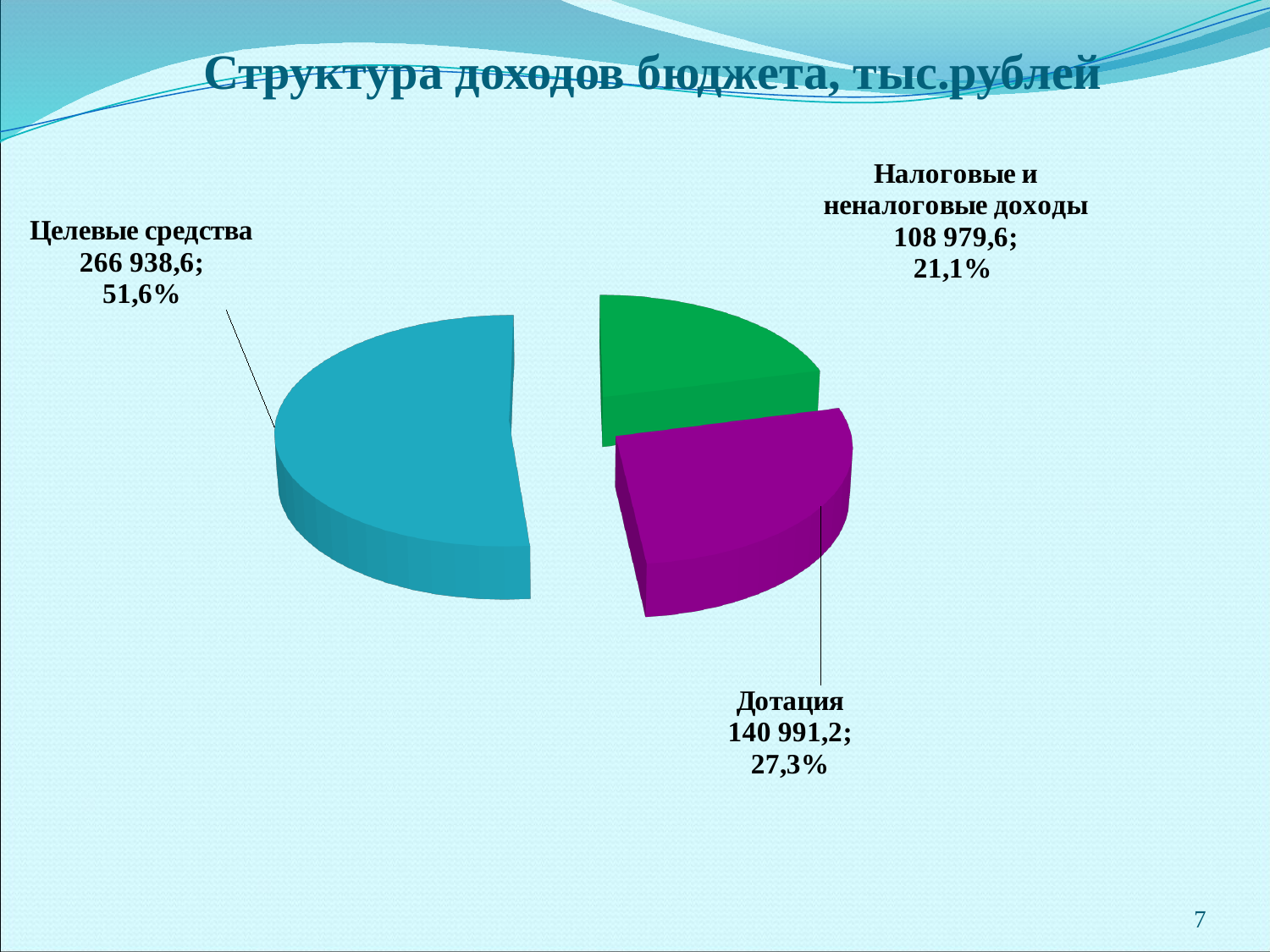
What share of the pie does Налоговые и неналоговые доходы represent? 21,1% Which is larger, Дотация or Налоговые и неналоговые доходы? Дотация What is the value for Целевые средства? 266 938,6 What kind of chart is shown on the slide? Pie chart What is the difference between the values for Целевые средства and Дотация? 125 947,4 Which category has the largest slice? Целевые средства What share of the pie does Целевые средства represent? 51,6% How many slices does the pie chart have? 3 What is the value for Дотация? 140 991,2 What share of the pie does Дотация represent? 27,3% Which category has the smallest slice? Налоговые и неналоговые доходы What is the value for Налоговые и неналоговые доходы? 108 979,6